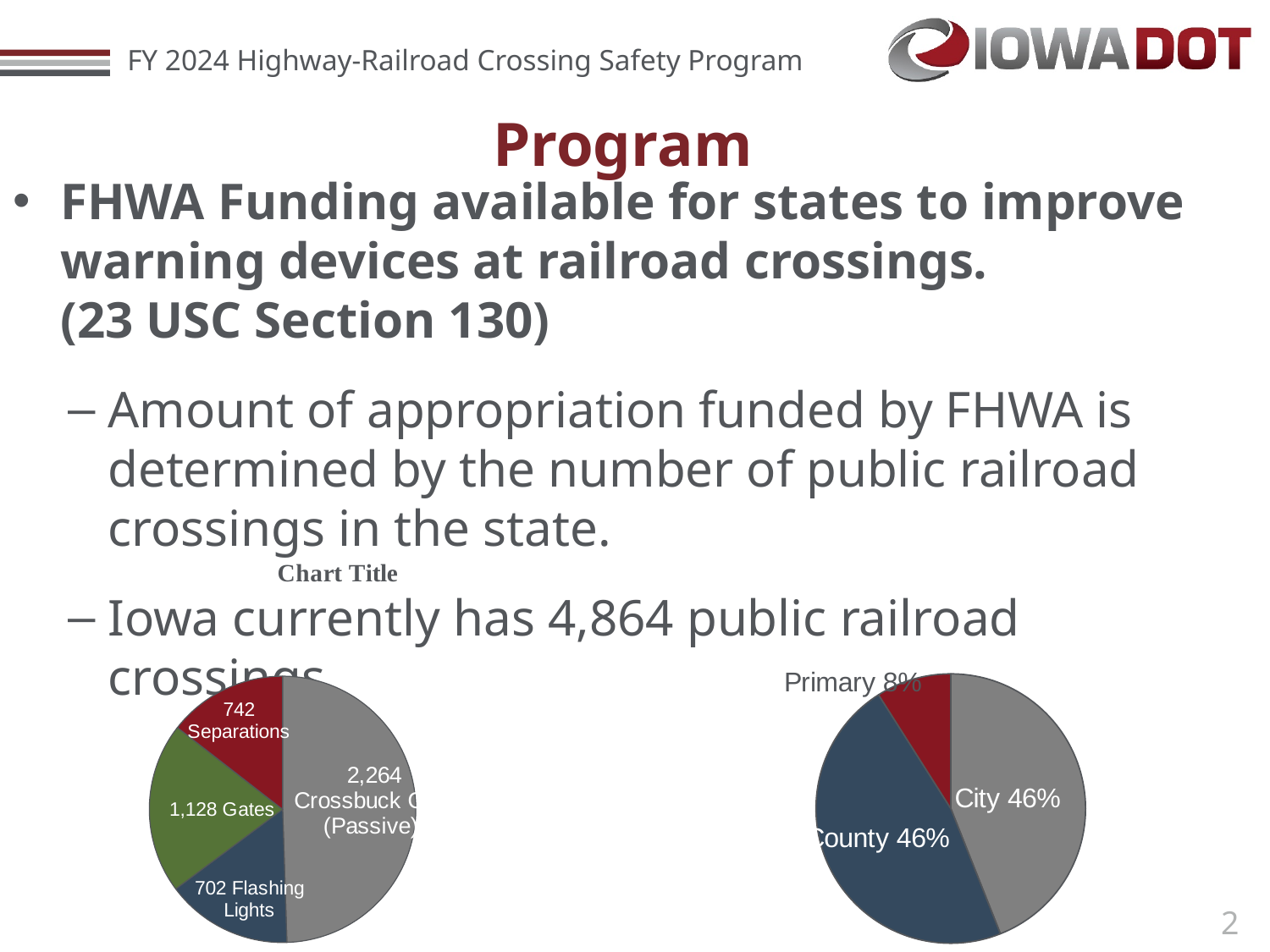
In the left pie chart, how many crossings are labelled as Gates? 1,128 In the right pie chart, which category has the smallest share? Primary In the right pie chart, what share does City have? 46% In the left pie chart, which category has the largest slice? Crossbuck (Passive) In the left pie chart, what is the value for Flashing Lights? 702 In the left pie chart, which category has the smallest slice? Flashing Lights What is the title shown above the left pie chart? Chart Title In the left pie chart, how many slices are there? 4 In the left pie chart, what is the difference between the Gates value and the Flashing Lights value? 426 In the left pie chart, what is the value for Crossbuck (Passive)? 2,264 In the right pie chart, which is larger, County or Primary? County What kind of chart is the left chart on the slide? pie chart